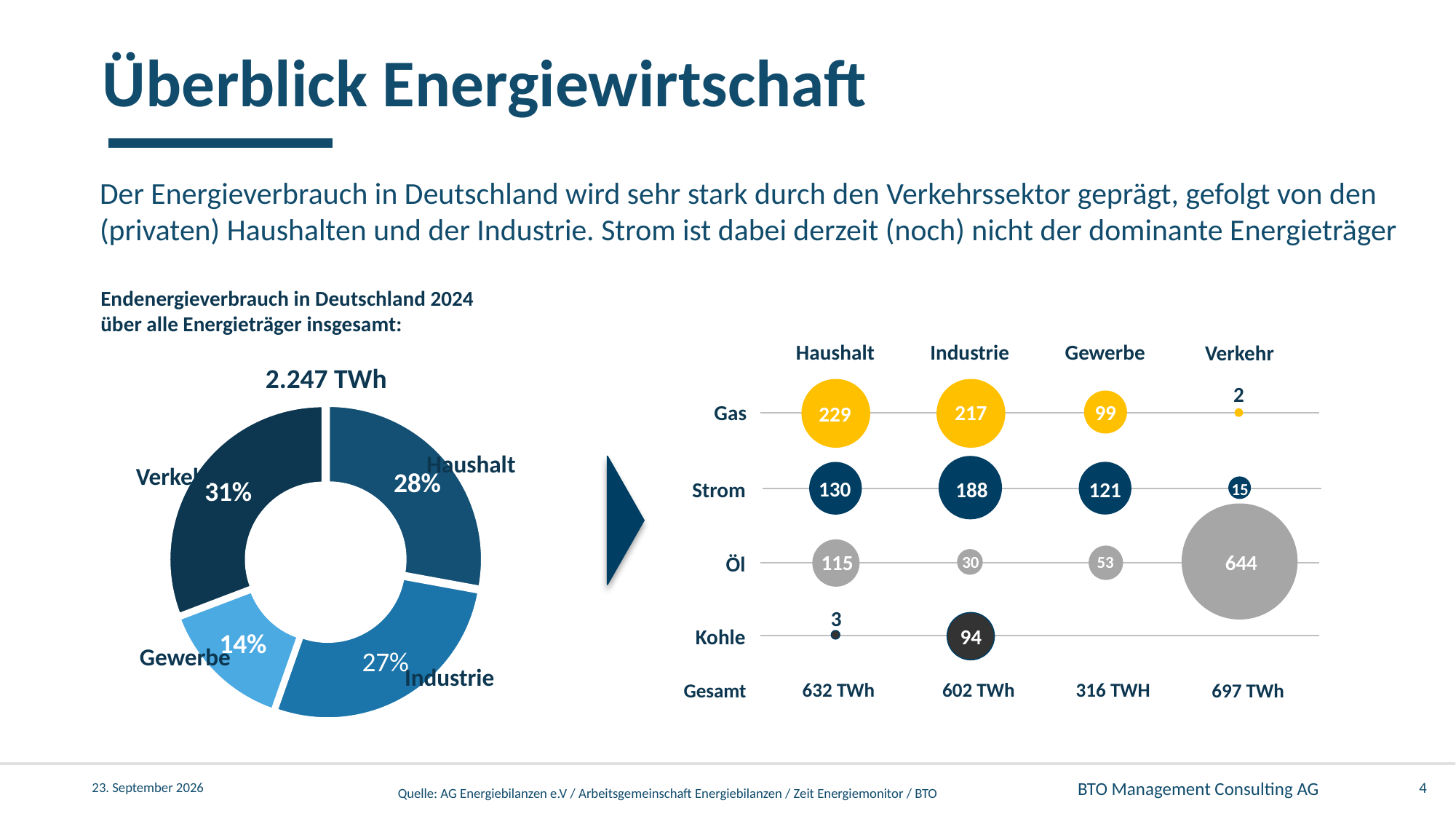
In the bubble chart on the right, which column has the highest Gesamt value? Verkehr In the donut chart on the left, what total value is shown above the chart? 2.247 TWh In the bubble chart on the right, what is the difference between Gas for Haushalt and Gas for Gewerbe? 130 In the donut chart on the left, what share does Verkehr have? 31% In the bubble chart on the right, what is the value for Öl in the Verkehr column? 644 In the donut chart on the left, what is the difference in percentage points between Haushalt and Gewerbe? 14 In the bubble chart on the right, what is the value for Strom in the Industrie column? 188 In the bubble chart on the right, what is the Gesamt value for Gewerbe? 316 TWH In the donut chart on the left, how many sectors are shown? 4 In the donut chart on the left, which sector has the largest share? Verkehr In the bubble chart on the right, which is larger: Gas for Haushalt or Gas for Industrie? Gas for Haushalt In the donut chart on the left, which sector has the smallest share? Gewerbe